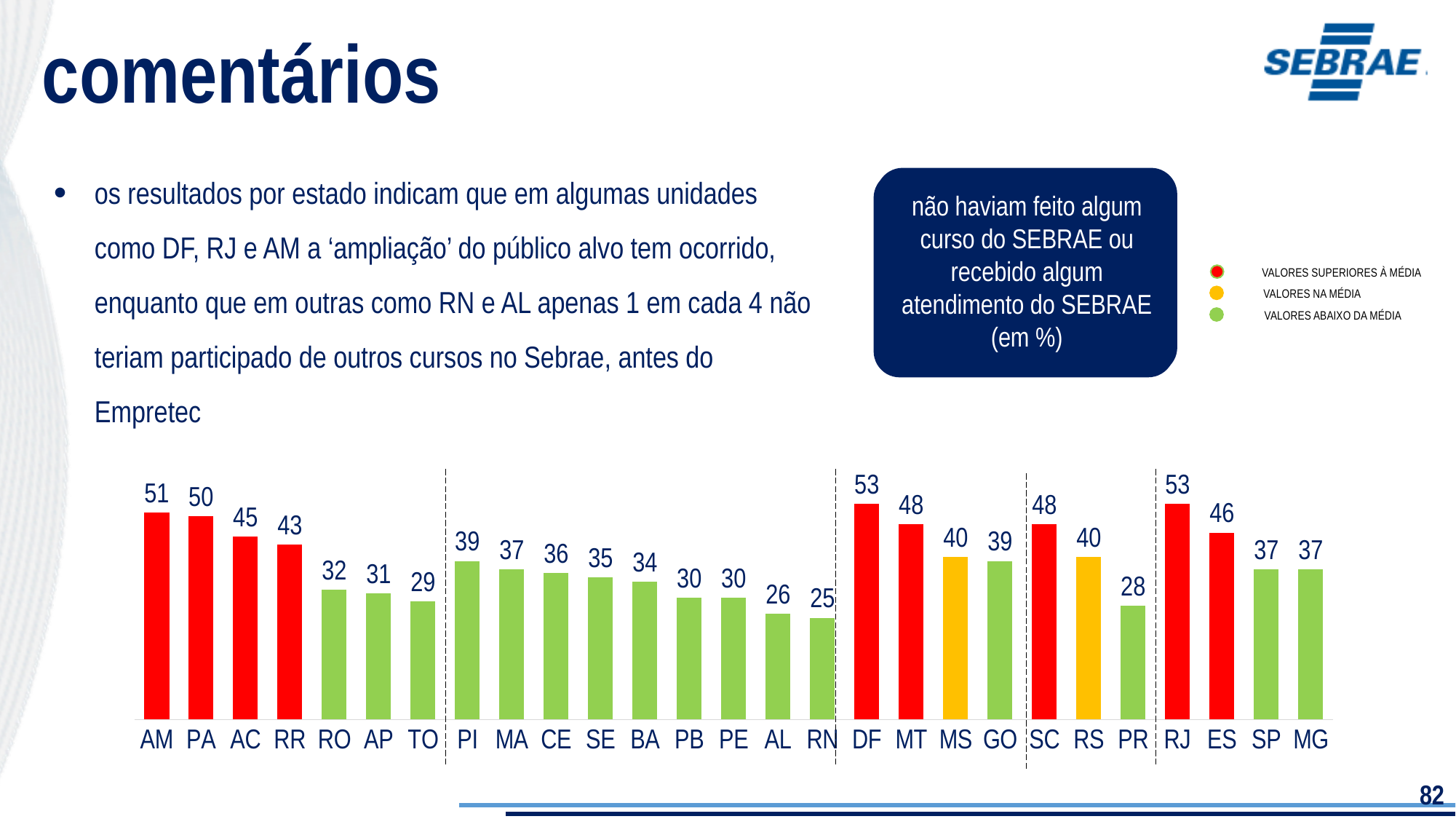
Which has a larger value, AL or SC? SC Which state has the lowest value in the chart? RN What is the value shown for RN? 25 What is the value shown for MS? 40 How many entries does the legend list? 3 What colour are the bars for values above the average (valores superiores à média)? Red What is the difference between the values for AM and TO? 22 What is the value shown for DF? 53 Which has a larger value, PI or PR? PI How many states are shown in the chart? 27 What is the difference between the values for RJ and ES? 7 What kind of chart is shown on the slide? Bar chart